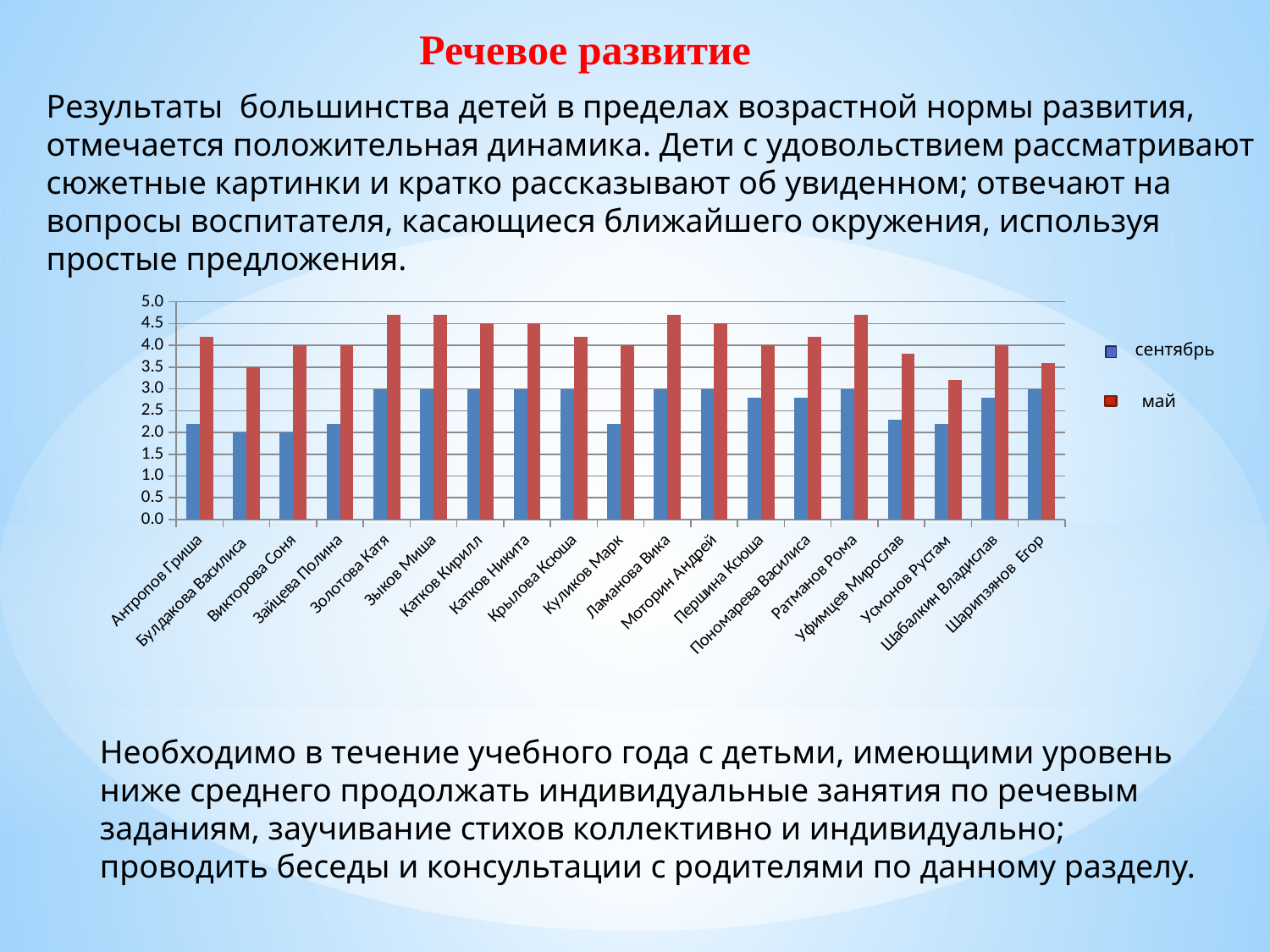
Which is larger for Антропов Гриша: the сентябрь value or the май value? май What is the май value for Катков Кирилл? 4.5 What is the май value for Викторова Соня? 4.0 How many series does the chart legend list? 2 What kind of chart is shown on the slide? bar chart How many children (categories) are shown on the x axis of the chart? 19 What is the сентябрь value for Булдакова Василиса? 2.0 Is the май value for Золотова Катя greater or less than 4.5? greater What are the two series named in the chart legend? сентябрь and май Is the май value for Усмонов Рустам greater or less than 3.5? less Which child has the lowest май value? Усмонов Рустам Is the сентябрь value for Уфимцев Мирослав greater or less than 2.5? less